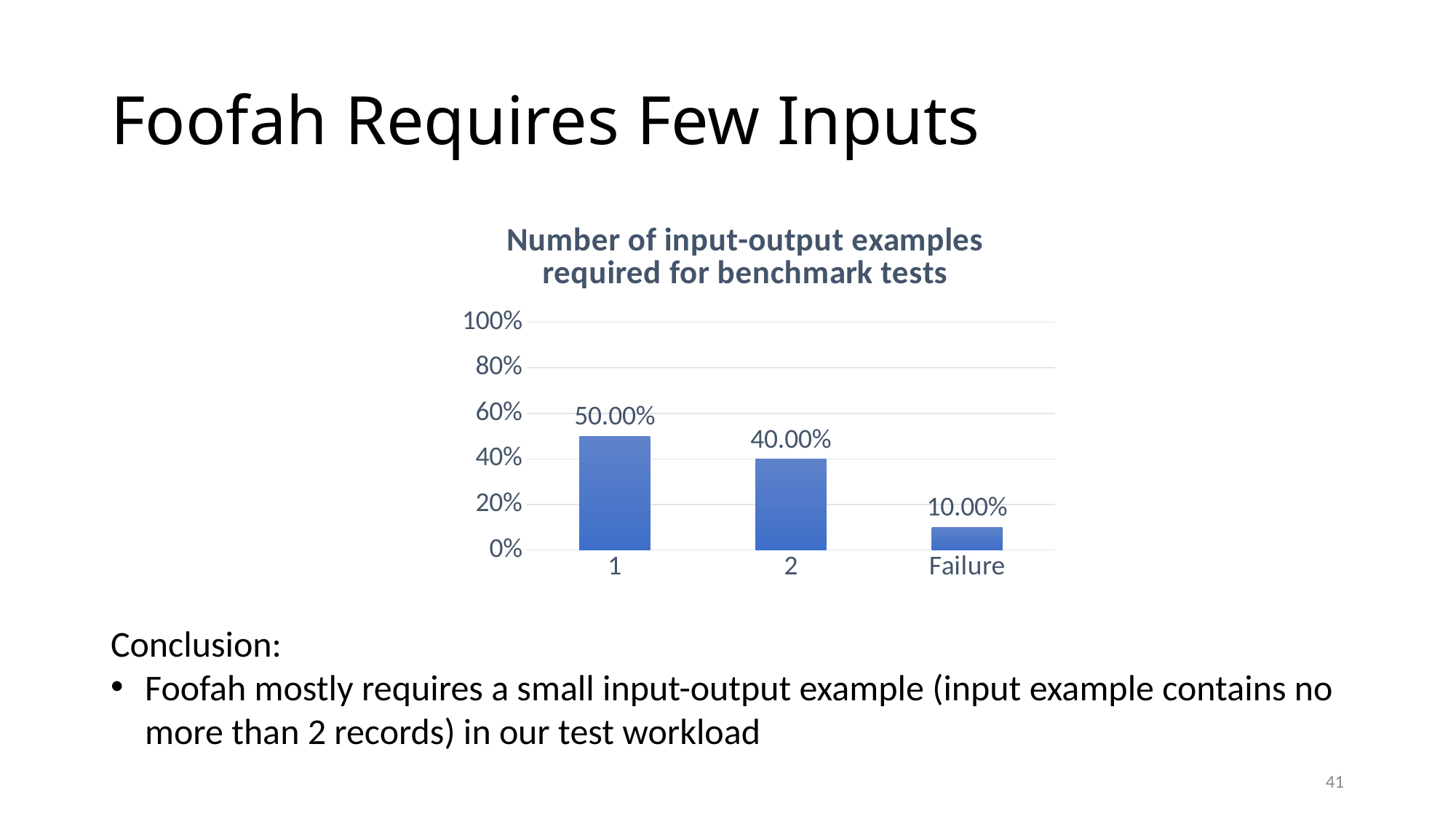
What is the value for category 1? 50.00% How many categories are shown on the x axis? 3 What is the value for Failure? 10.00% Is the value for category 1 greater or less than 40%? greater What kind of chart is shown on the slide? bar chart What is the value for category 2? 40.00% Which category has the lowest value? Failure What is the difference between the values for category 2 and Failure? 30.00% Which category has the highest value? 1 What is the difference between the values for category 1 and category 2? 10.00% What is the title of the chart? Number of input-output examples required for benchmark tests Which is larger, the value for category 2 or the value for Failure? 2